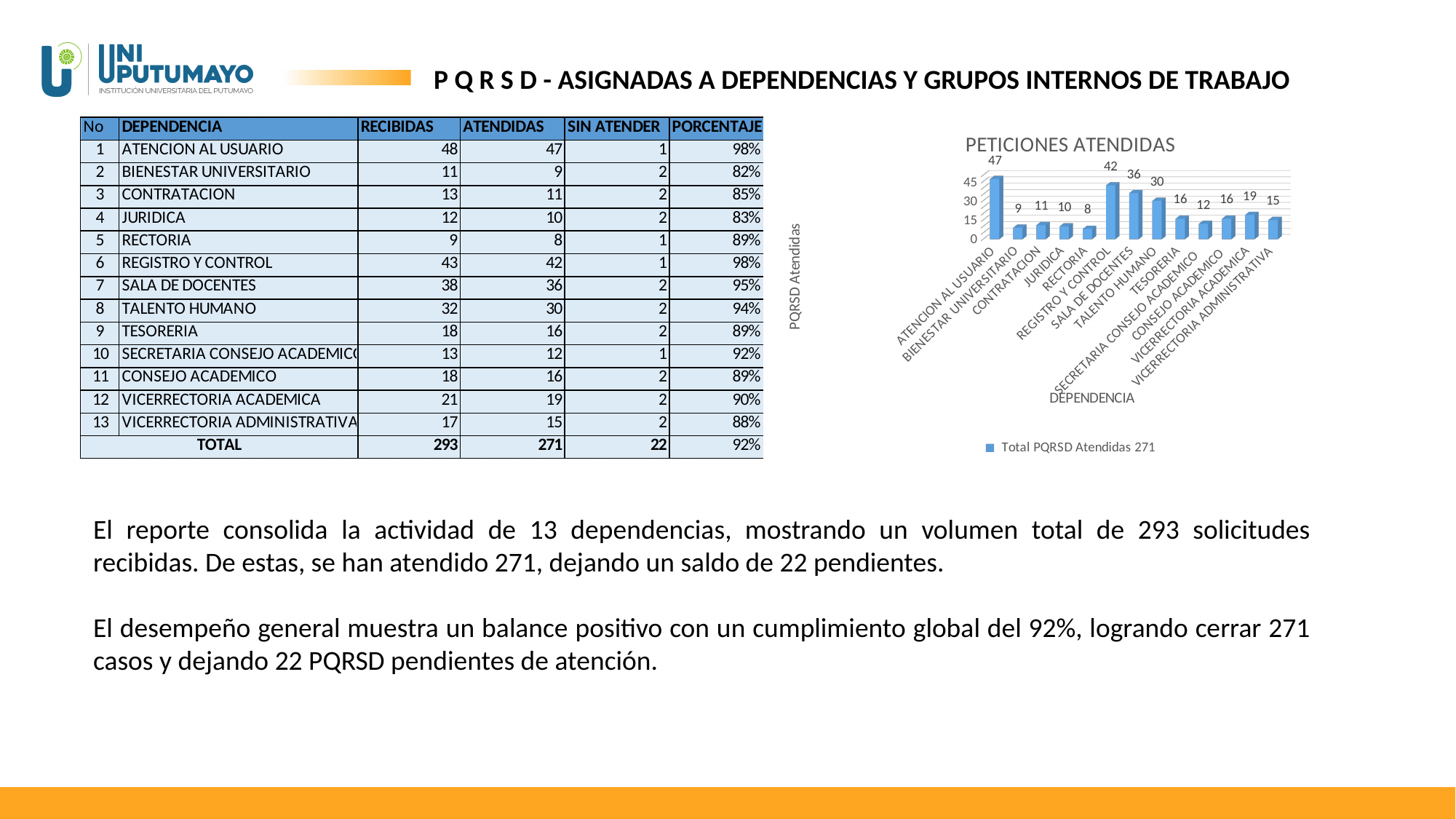
Which category has the lowest value in the chart? RECTORIA What type of chart is shown on the slide? bar chart What is the title of the chart? PETICIONES ATENDIDAS In the chart, what is the value for ATENCION AL USUARIO? 47 How many series does the chart legend list? 1 What is the difference between the values for SALA DE DOCENTES and TALENTO HUMANO? 6 Which is larger in the chart, the value for CONTRATACION or the value for JURIDICA? CONTRATACION In the chart, what is the value for VICERRECTORIA ACADEMICA? 19 In the chart, what is the value for REGISTRO Y CONTROL? 42 What is the legend entry of the chart? Total PQRSD Atendidas 271 How many categories are plotted in the chart? 13 Which category has the highest value in the chart? ATENCION AL USUARIO